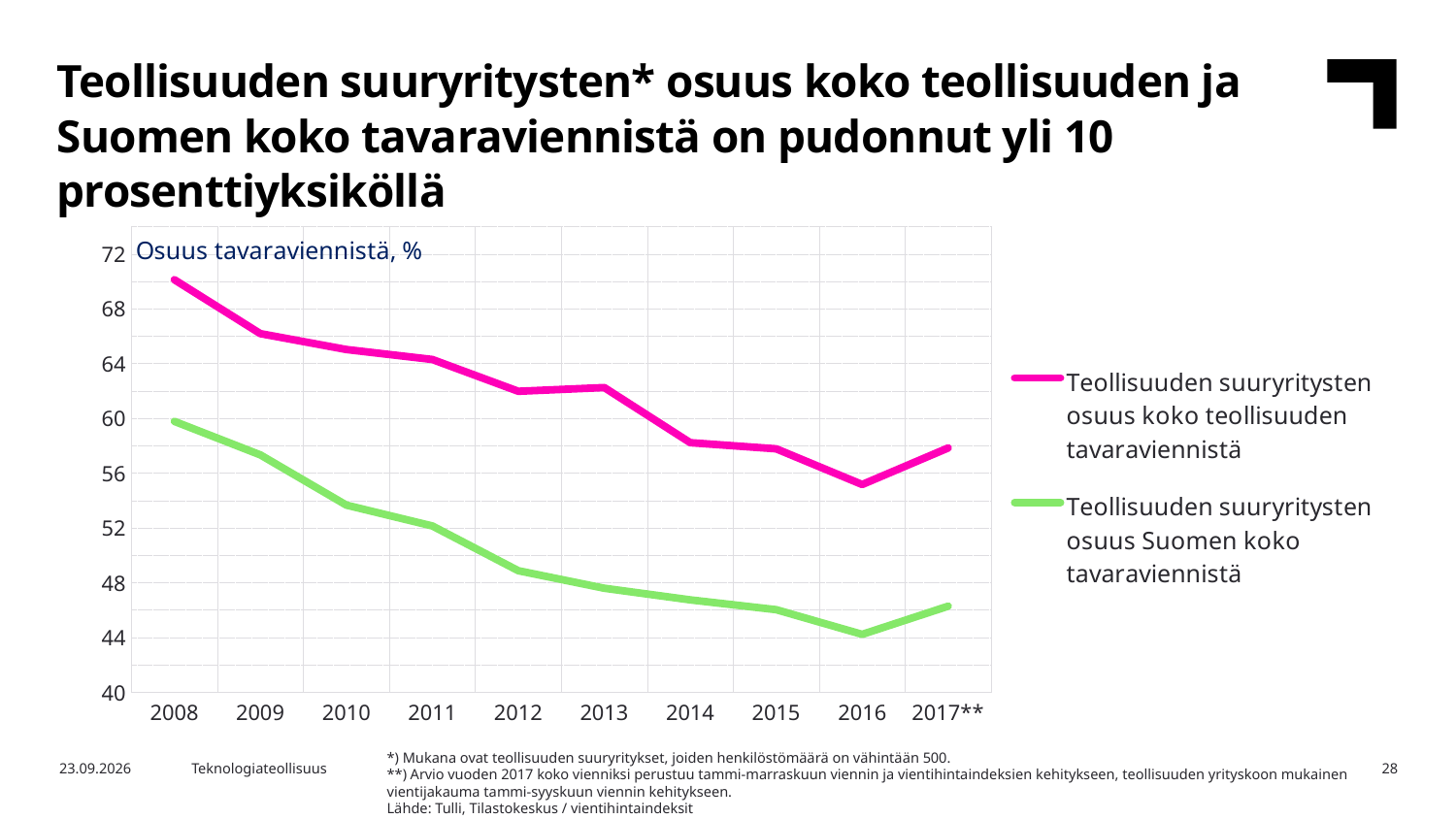
What kind of chart is shown on the slide? Line chart How many series does the legend list? 2 Which series has the higher value in 2014: 'Teollisuuden suuryritysten osuus koko teollisuuden tavaraviennistä' or 'Teollisuuden suuryritysten osuus Suomen koko tavaraviennistä'? Teollisuuden suuryritysten osuus koko teollisuuden tavaraviennistä Which year has the lowest value for 'Teollisuuden suuryritysten osuus Suomen koko tavaraviennistä'? 2016 How many years are shown on the x axis? 10 Is the value for 'Teollisuuden suuryritysten osuus Suomen koko tavaraviennistä' in 2012 greater or less than 52? less Which year has the lowest value for 'Teollisuuden suuryritysten osuus koko teollisuuden tavaraviennistä'? 2016 Do the values for 'Teollisuuden suuryritysten osuus Suomen koko tavaraviennistä' generally rise or fall from 2008 to 2016? Fall Which year has the highest value for 'Teollisuuden suuryritysten osuus koko teollisuuden tavaraviennistä'? 2008 What colour is the line for 'Teollisuuden suuryritysten osuus Suomen koko tavaraviennistä'? Green Is the value for 'Teollisuuden suuryritysten osuus koko teollisuuden tavaraviennistä' in 2008 greater or less than 68? greater Is the value for 'Teollisuuden suuryritysten osuus Suomen koko tavaraviennistä' in 2016 greater or less than 48? less